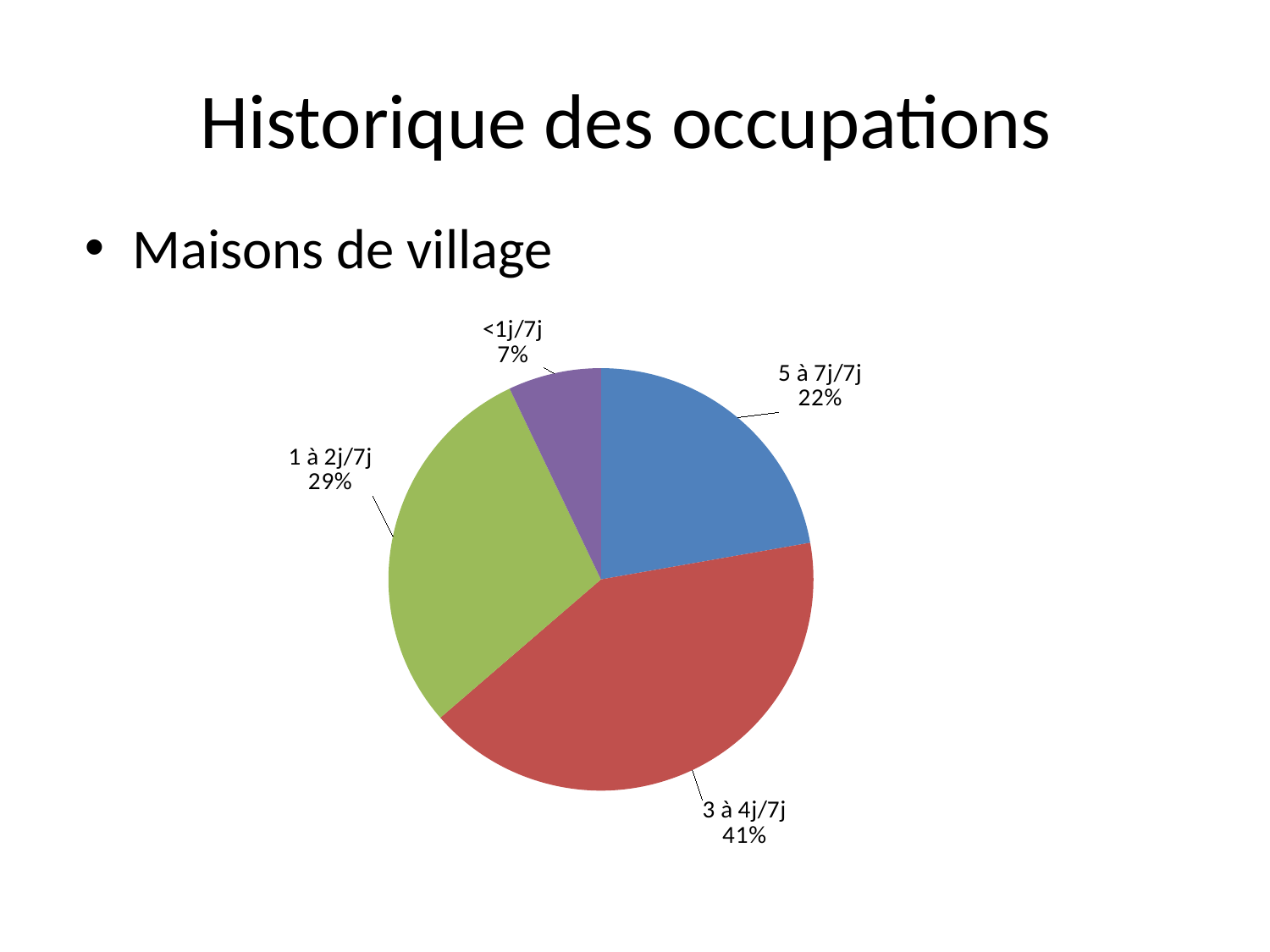
What colour is the "3 à 4j/7j" slice? red What share of the pie does the "5 à 7j/7j" slice represent? 22% Which is larger, the "5 à 7j/7j" slice or the "1 à 2j/7j" slice? 1 à 2j/7j What is the difference in percentage points between the "3 à 4j/7j" slice and the "1 à 2j/7j" slice? 12 What share of the pie does the "1 à 2j/7j" slice represent? 29% Which category has the smallest slice of the pie? <1j/7j What share of the pie does the "<1j/7j" slice represent? 7% Which category has the largest slice of the pie? 3 à 4j/7j What kind of chart is shown on the slide? pie chart How many slices does the pie chart have? 4 What is the difference in percentage points between the "5 à 7j/7j" slice and the "<1j/7j" slice? 15